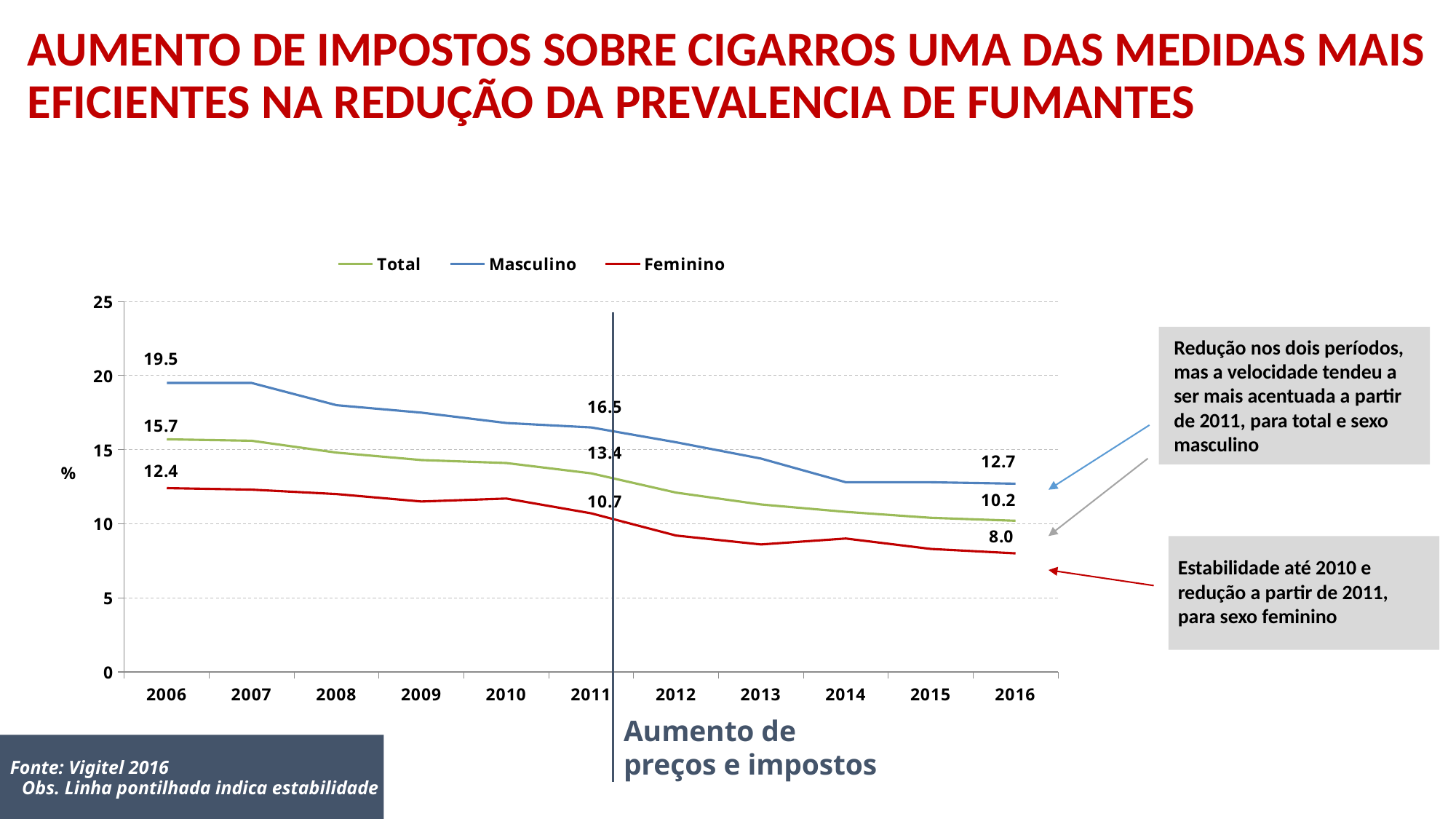
Which series has the highest value in 2016? Masculino Does the Total series rise or fall from 2006 to 2016? fall What is the value for Masculino in 2006? 19.5 What is the value for Total in 2011? 13.4 Is the value for Masculino in 2014 greater or less than 15? less How many years are shown on the x axis? 11 What is the difference between the Total and Feminino values in 2011? 2.7 How many series does the legend list? 3 Which series has the lowest value in 2006? Feminino What is the value for Feminino in 2016? 8.0 What type of chart is shown on the slide? line chart What is the difference between the Masculino values in 2006 and 2016? 6.8